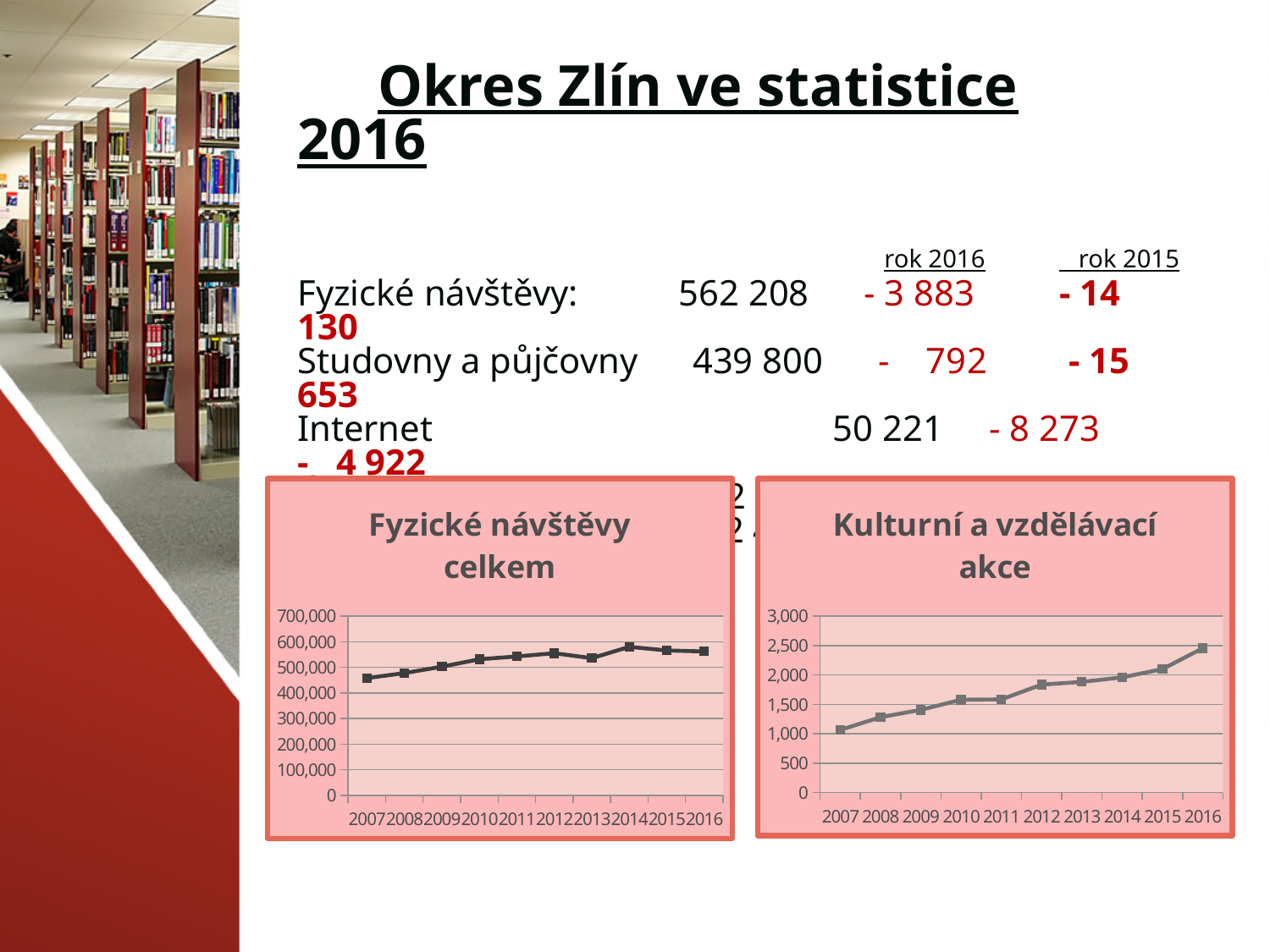
In the "Fyzické návštěvy celkem" chart, which year has the lowest value? 2007 In the "Kulturní a vzdělávací akce" chart, is the value for 2008 greater or less than 1,500? less In the "Kulturní a vzdělávací akce" chart, do the values generally rise or fall from 2007 to 2016? rise How many years are plotted on the "Fyzické návštěvy celkem" chart? 10 In the "Kulturní a vzdělávací akce" chart, is the value for 2016 greater or less than 2,000? greater In the "Kulturní a vzdělávací akce" chart, which year has the lowest value? 2007 In the "Fyzické návštěvy celkem" chart, is the value for 2007 greater or less than 500,000? less What type of chart is the "Fyzické návštěvy celkem" chart? line chart How many data points does the "Kulturní a vzdělávací akce" chart show? 10 In the "Kulturní a vzdělávací akce" chart, which year has the highest value? 2016 What type of chart is the "Kulturní a vzdělávací akce" chart? line chart